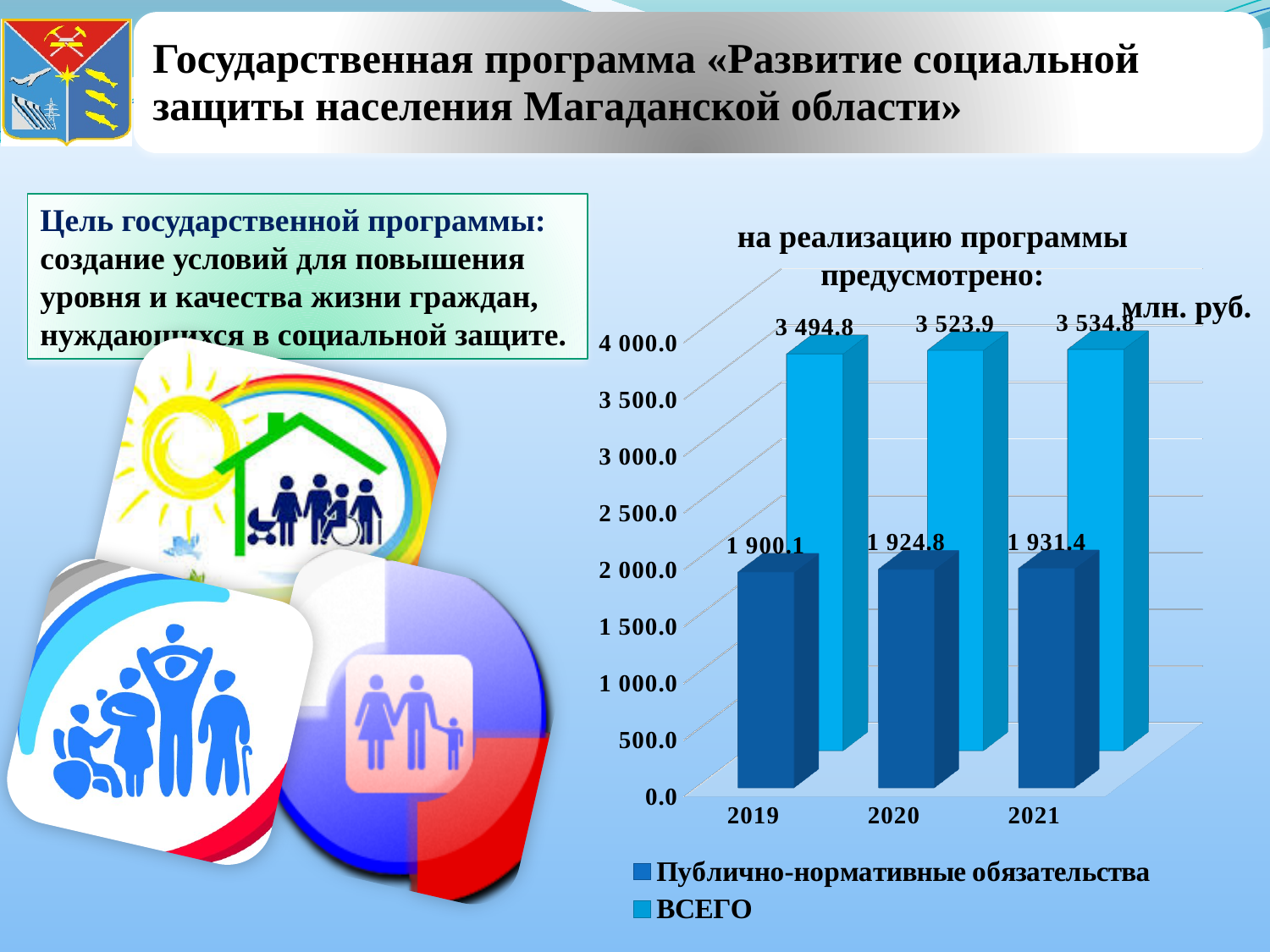
In which year is the Публично-нормативные обязательства value lowest? 2019 What is the value for Публично-нормативные обязательства in 2020? 1 924.8 What is the value for ВСЕГО in 2019? 3 494.8 Do the ВСЕГО values rise or fall from 2019 to 2021? rise In which year is the ВСЕГО value highest? 2021 What is the value for ВСЕГО in 2020? 3 523.9 What is the value for Публично-нормативные обязательства in 2021? 1 931.4 How many years are shown on the x axis of the chart? 3 How many series does the chart legend list? 2 What is the difference between ВСЕГО and Публично-нормативные обязательства in 2019? 1 594.7 By how much did the ВСЕГО value increase from 2019 to 2021? 40.0 Which is larger: ВСЕГО in 2019 or Публично-нормативные обязательства in 2021? ВСЕГО in 2019